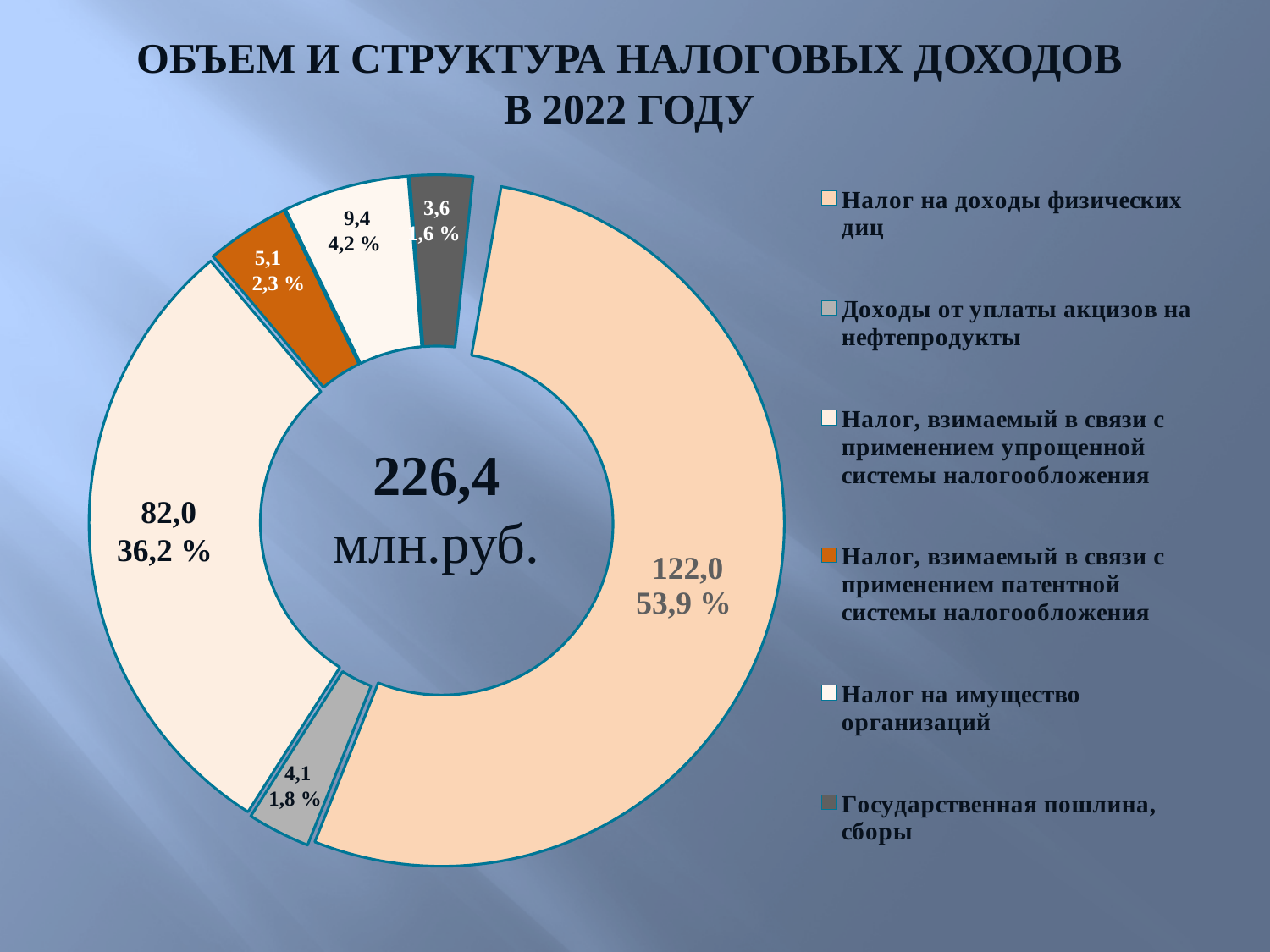
How many categories does the legend list? 6 What share of the chart does "Налог на доходы физических лиц" represent? 53,9 % What is the value shown for "Налог, взимаемый в связи с применением упрощенной системы налогообложения"? 82,0 What total is printed in the centre of the chart? 226,4 млн.руб. Which category has the largest slice? Налог на доходы физических лиц What is the value shown for "Налог на имущество организаций"? 9,4 What kind of chart is shown on the slide? Doughnut (pie) chart What share of the chart does "Налог, взимаемый в связи с применением патентной системы налогообложения" represent? 2,3 % Which category has the smallest slice? Государственная пошлина, сборы What is the difference between the values for "Налог на доходы физических лиц" and "Налог, взимаемый в связи с применением упрощенной системы налогообложения"? 40,0 What share of the chart does "Государственная пошлина, сборы" represent? 1,6 % What is the value shown for "Налог на доходы физических лиц"? 122,0